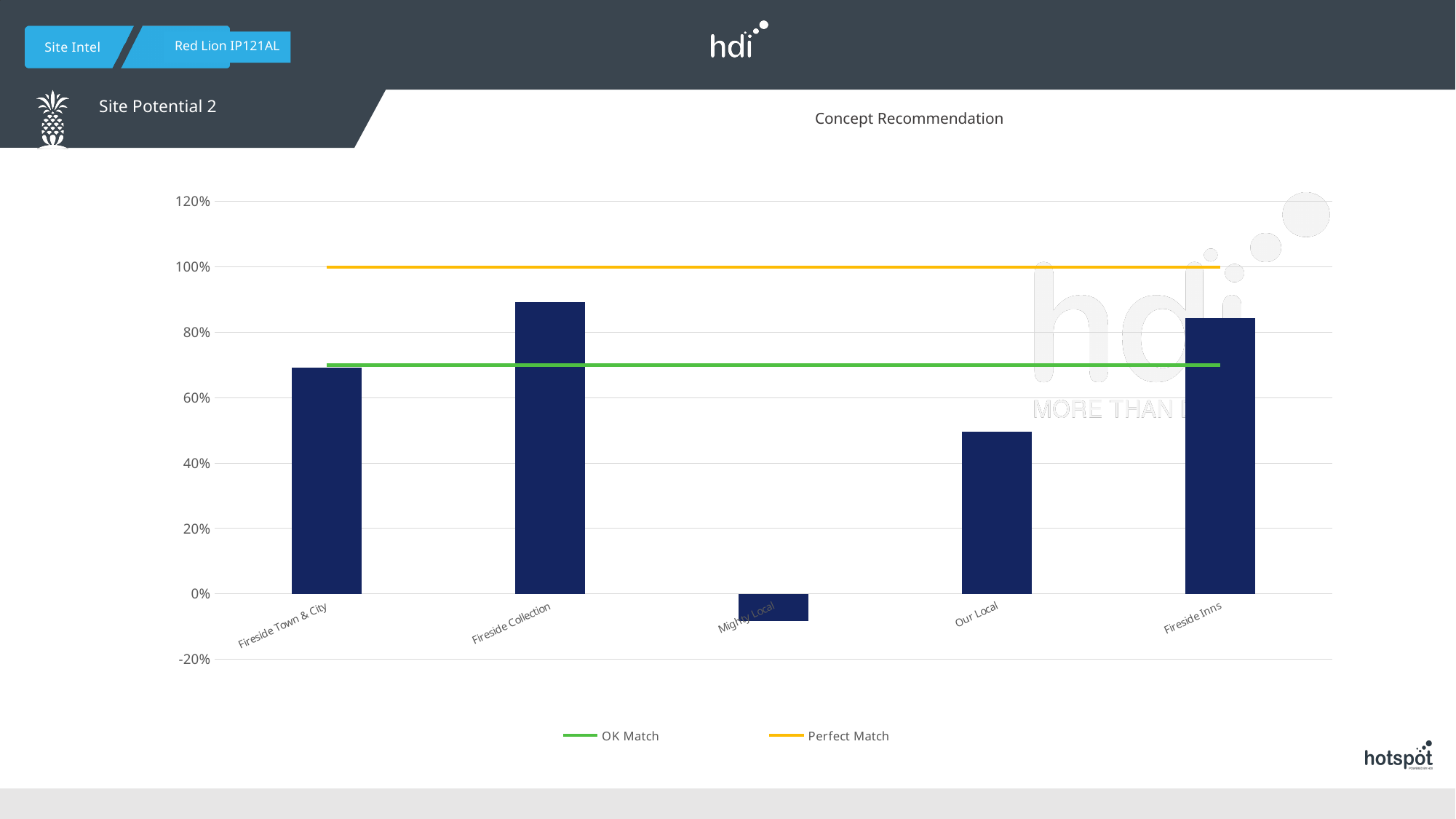
How many categories are shown on the x axis of the chart? 5 Is the value for Fireside Town & City greater or less than 60%? greater How many series does the chart's legend list? 2 Which category has the lowest bar in the chart? Mighty Local Which is larger, the value for Fireside Collection or the value for Our Local? Fireside Collection What kind of chart is shown on the slide? combination bar and line chart Which category has the highest bar in the chart? Fireside Collection Is the value for Mighty Local greater or less than 0%? less What is the title shown above the chart? Concept Recommendation At what level on the y axis is the Perfect Match line drawn? 100% Is the value for Our Local greater or less than 60%? less